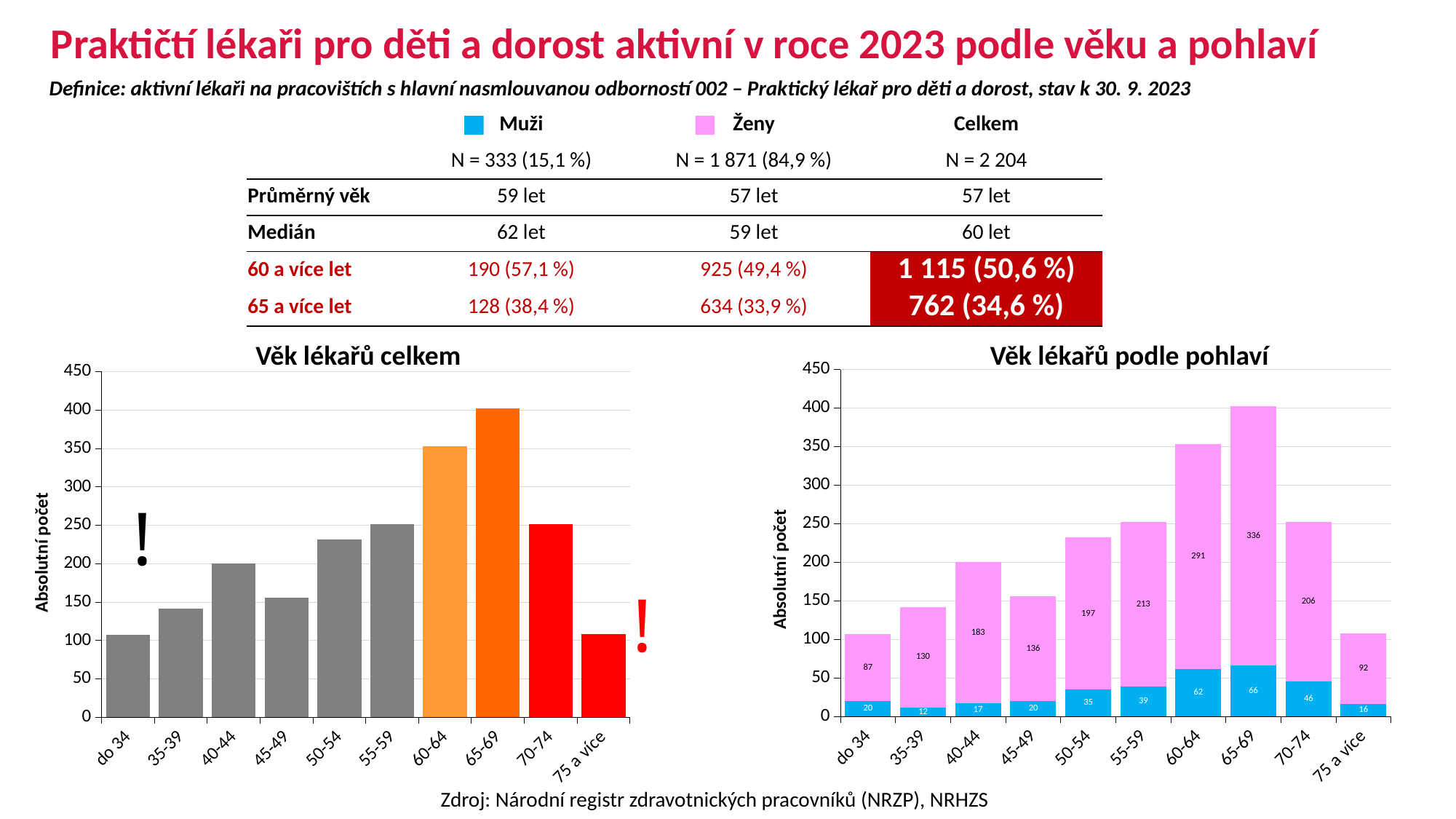
In the chart 'Věk lékařů podle pohlaví', what is the value for Ženy in the 65-69 age group? 336 In the chart 'Věk lékařů podle pohlaví', which age group has the highest value for Ženy? 65-69 In the chart 'Věk lékařů celkem', which age group has the highest value? 65-69 In the chart 'Věk lékařů podle pohlaví', what is the total of the stacked bar for the 65-69 age group? 402 In the chart 'Věk lékařů podle pohlaví', what is the value for Muži in the 60-64 age group? 62 In the chart 'Věk lékařů podle pohlaví', what is the difference between the Ženy values for 65-69 and 60-64? 45 How many age groups are shown on the x axis of the chart 'Věk lékařů celkem'? 10 In the chart 'Věk lékařů celkem', is the value for 50-54 greater or less than 200? greater How many series does the legend list for the chart 'Věk lékařů podle pohlaví'? 2 What kind of chart is 'Věk lékařů celkem'? bar chart In the chart 'Věk lékařů podle pohlaví', which age group has the lowest value for Muži? 35-39 In the chart 'Věk lékařů podle pohlaví', which is larger: the Ženy value for 50-54 or for 55-59? 55-59